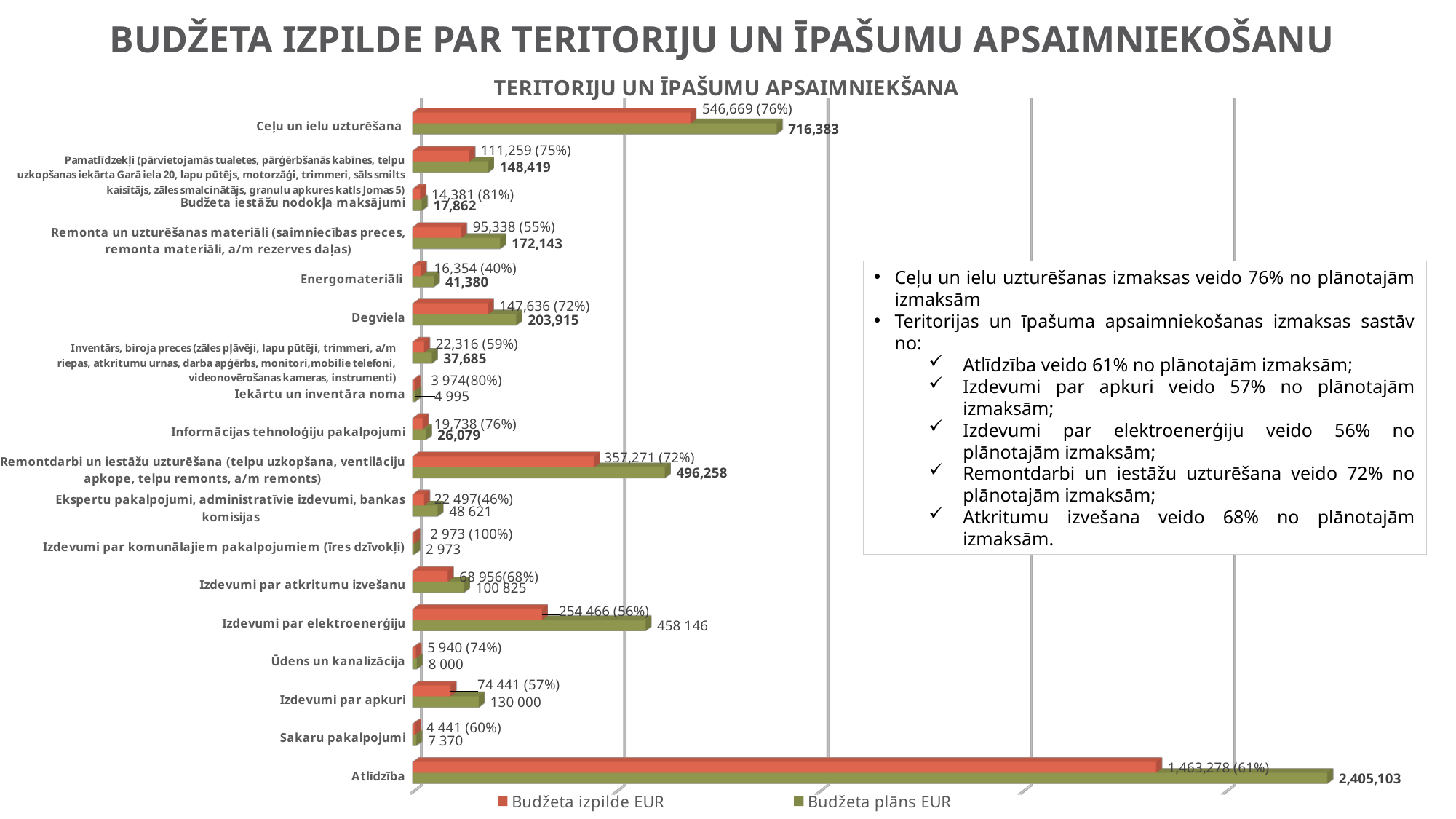
What type of chart is shown on the slide? bar chart Which category has the lowest Budžeta plāns EUR value? Izdevumi par komunālajiem pakalpojumiem (īres dzīvokļi) What is the Budžeta izpilde EUR value for Atlīdzība? 1,463,278 Which category has the highest Budžeta plāns EUR value? Atlīdzība What are the two series named in the legend? Budžeta izpilde EUR and Budžeta plāns EUR How many categories are shown on the chart? 18 What percentage of the plan was executed for Energomateriāli? 40% What is the Budžeta plāns EUR value for Izdevumi par apkuri? 130 000 How many series does the legend list? 2 What is the Budžeta plāns EUR value for Degviela? 203,915 Which has the larger Budžeta plāns EUR value, Degviela or Remonta un uzturēšanas materiāli? Degviela What is the difference between the Budžeta plāns EUR and Budžeta izpilde EUR values for Ceļu un ielu uzturēšana? 169,714